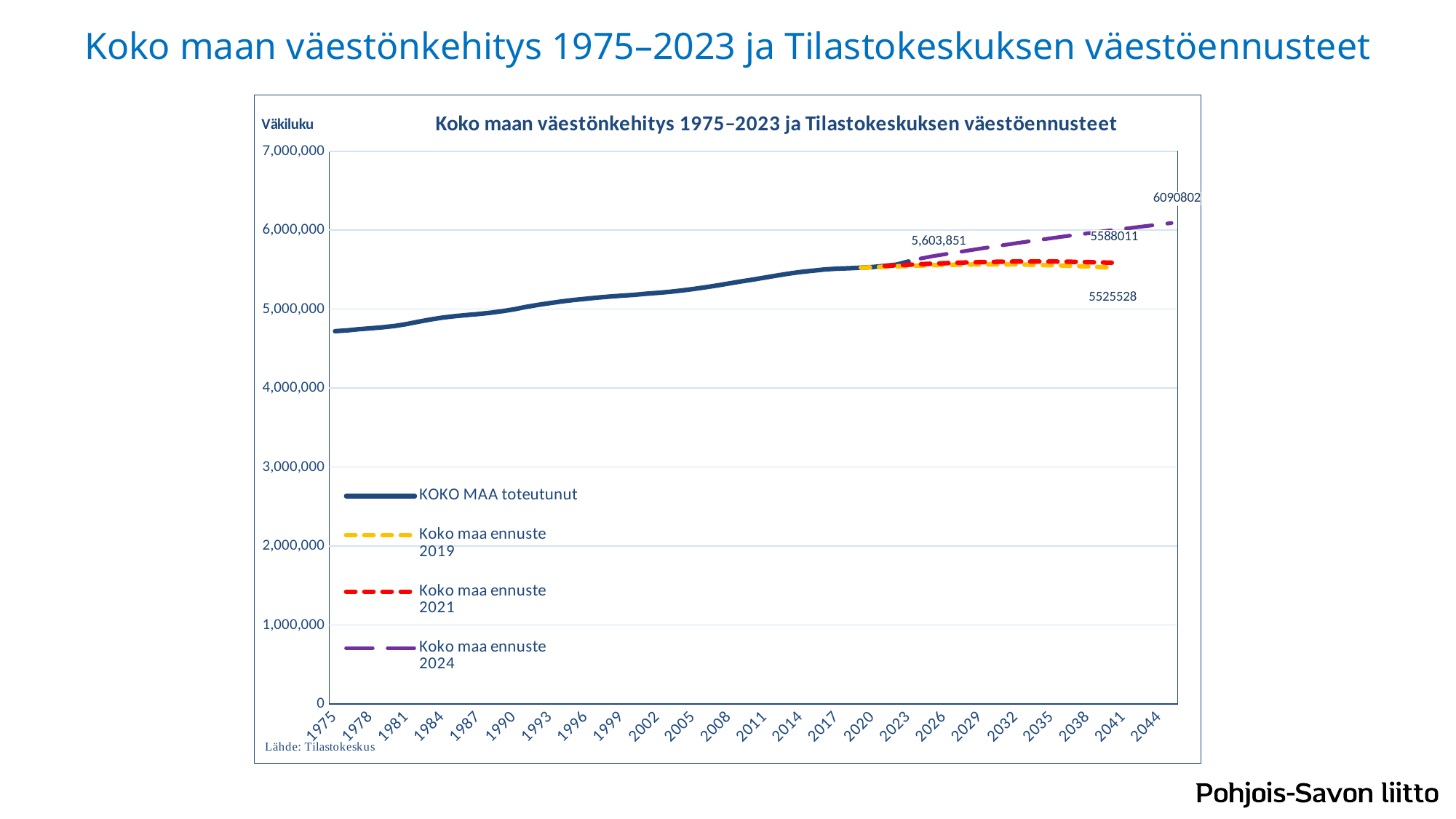
Is the KOKO MAA toteutunut value for 1975 greater or less than 5,000,000? less What is the label on the vertical axis of the chart? Väkiluku What kind of chart is shown on the slide? Line chart Does the KOKO MAA toteutunut series rise or fall from 1975 to 2023? Rises Which forecast series has the lowest labelled end value? Koko maa ennuste 2019 What is the labelled value at the end of the KOKO MAA toteutunut series? 5,603,851 Which forecast series reaches the highest labelled value? Koko maa ennuste 2024 How many series does the legend list? 4 What is the labelled end value of the Koko maa ennuste 2019 series? 5525528 What is the difference between the labelled end values of the Koko maa ennuste 2024 and Koko maa ennuste 2021 series? 502791 What is the labelled end value of the Koko maa ennuste 2021 series? 5588011 What is the labelled end value of the Koko maa ennuste 2024 series? 6090802